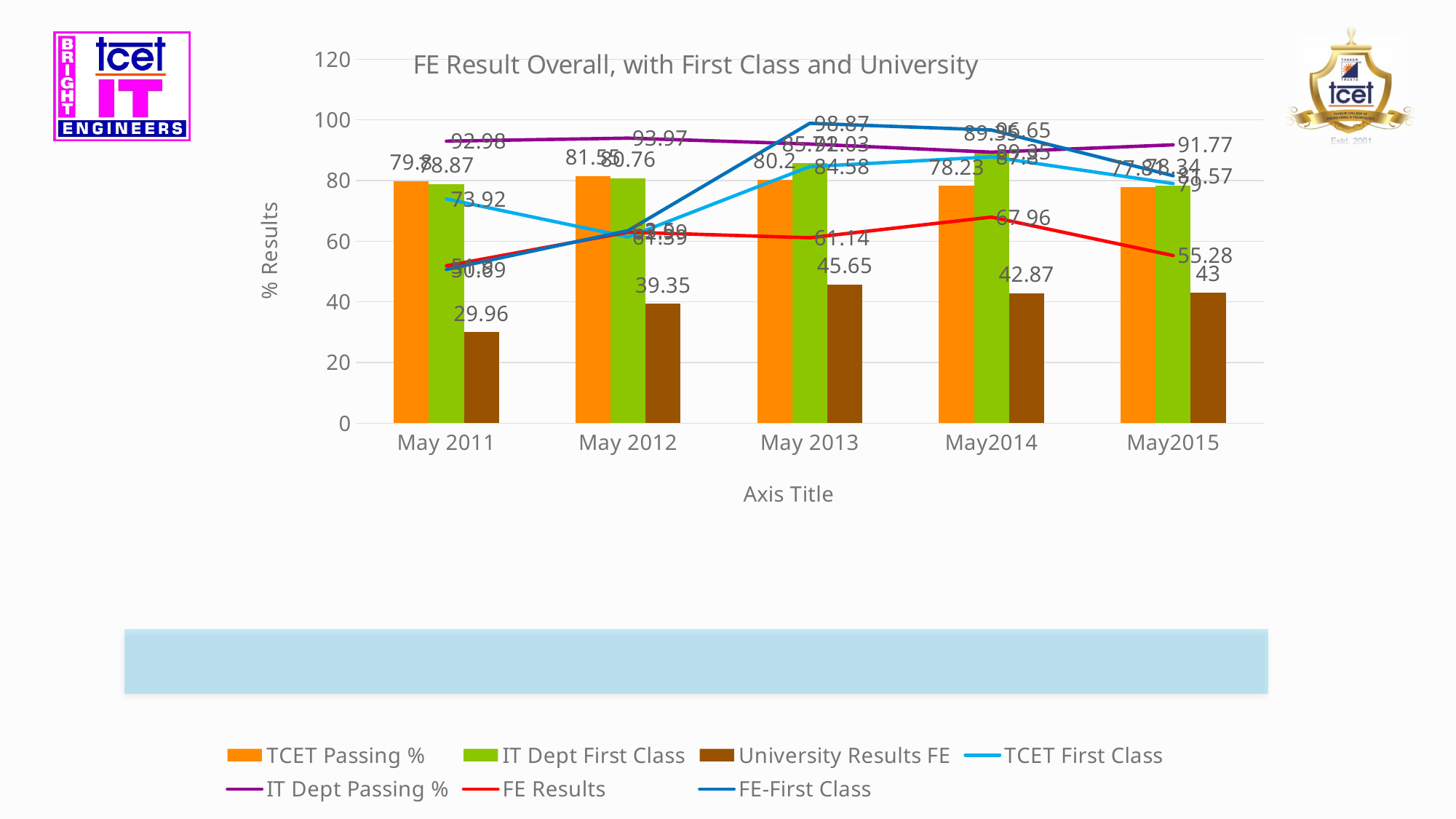
What is the value of University Results FE for May 2013? 45.65 In which category is University Results FE the highest? May 2013 What is the title of the chart? FE Result Overall, with First Class and University Which is larger for University Results FE: May 2012 or May2014? May2014 What kind of chart is shown on the slide? A combined bar and line chart In which category is University Results FE the lowest? May 2011 What is the difference between University Results FE in May 2013 and May 2011? 15.69 What is the value of IT Dept Passing % for May2015? 91.77 How many series does the chart's legend list? 7 What is the value of FE Results for May2014? 67.96 How many categories are shown on the x axis of the chart? 5 What is the value of University Results FE for May 2011? 29.96